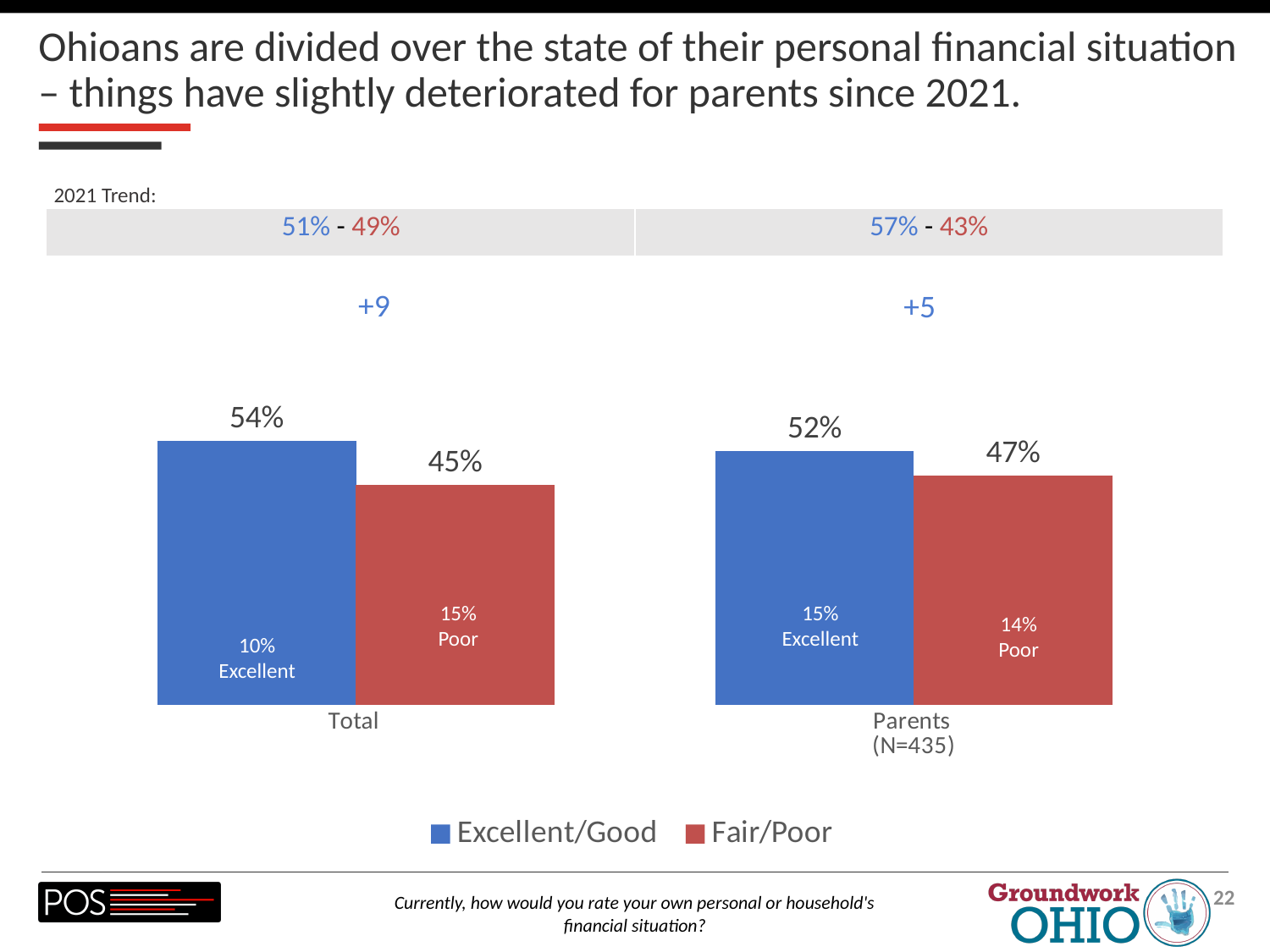
What is the Fair/Poor value for Parents (N=435)? 47% Which is larger for Parents (N=435): Excellent/Good or Fair/Poor? Excellent/Good What is the Excellent/Good value for Parents (N=435)? 52% What is the Fair/Poor value for Total? 45% What share of Parents rated their financial situation Poor? 14% What is the difference between the Excellent/Good and Fair/Poor values for Total? 9 What share of the Total group rated their financial situation Excellent? 10% What kind of chart is shown on the slide? Bar chart Which category has the higher Fair/Poor value, Total or Parents (N=435)? Parents (N=435) What is the Excellent/Good value for Total? 54% How many series does the legend list? 2 What was the 2021 Excellent/Good value for Parents shown in the trend row? 57%